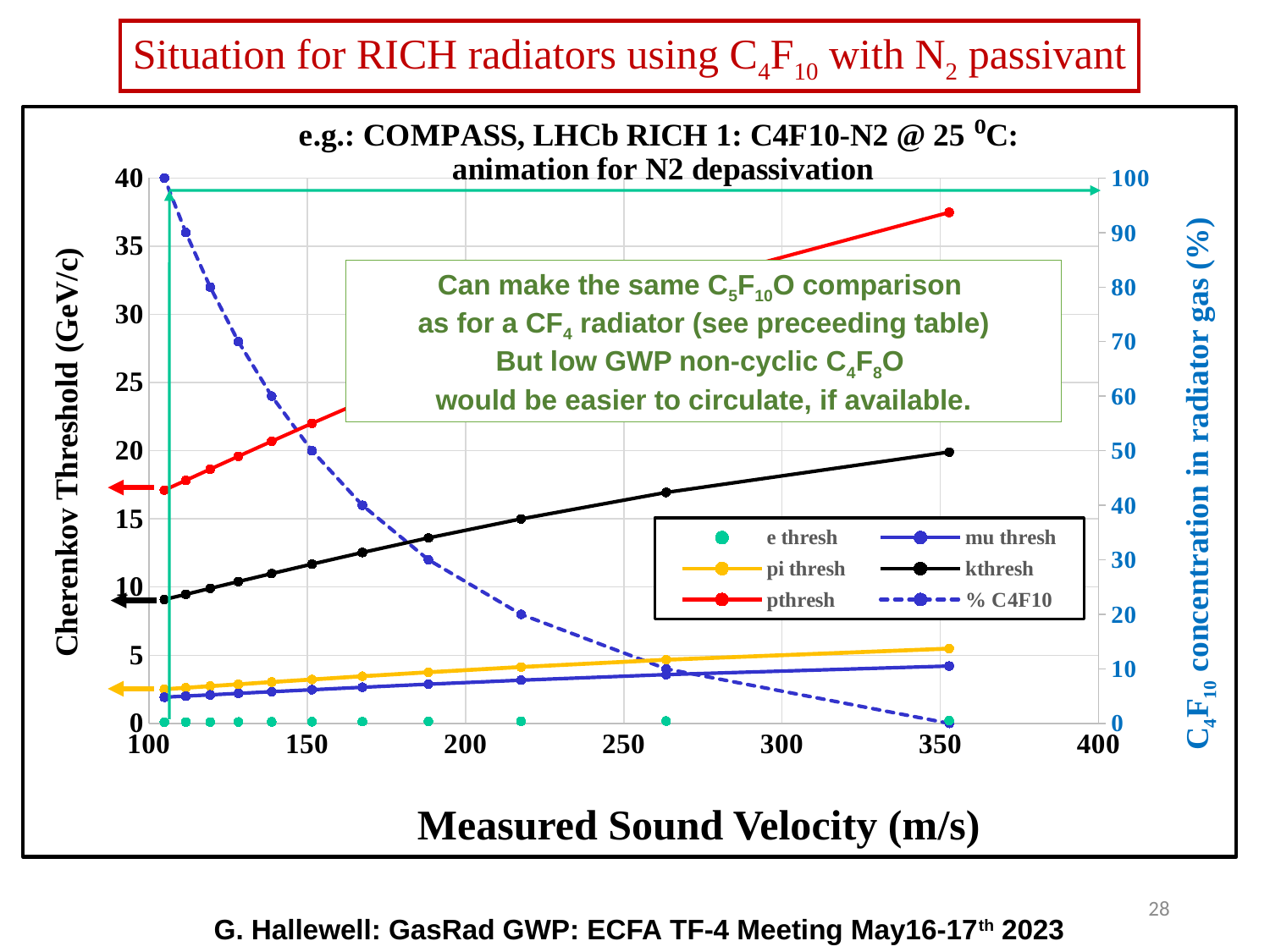
At the highest plotted sound velocity (around 350 m/s), is the kthresh value greater or less than 15 GeV/c? greater Which series has the lowest Cherenkov threshold values across the chart? e thresh Does the % C4F10 series rise or fall as the measured sound velocity increases? fall At the highest plotted sound velocity (around 350 m/s), is the pthresh value greater or less than 35 GeV/c? greater What kind of chart is shown on the slide? line chart Which series has the highest Cherenkov threshold values across the chart? pthresh What is the label of the x axis? Measured Sound Velocity (m/s) Does the kthresh series rise or fall as the measured sound velocity increases? rise How many series does the legend list? 6 At the highest plotted sound velocity (around 350 m/s), which is larger, the kthresh value or the pthresh value? pthresh What colour is the pthresh series drawn in? red At the highest plotted sound velocity (around 350 m/s), is the mu thresh value greater or less than 5 GeV/c? less